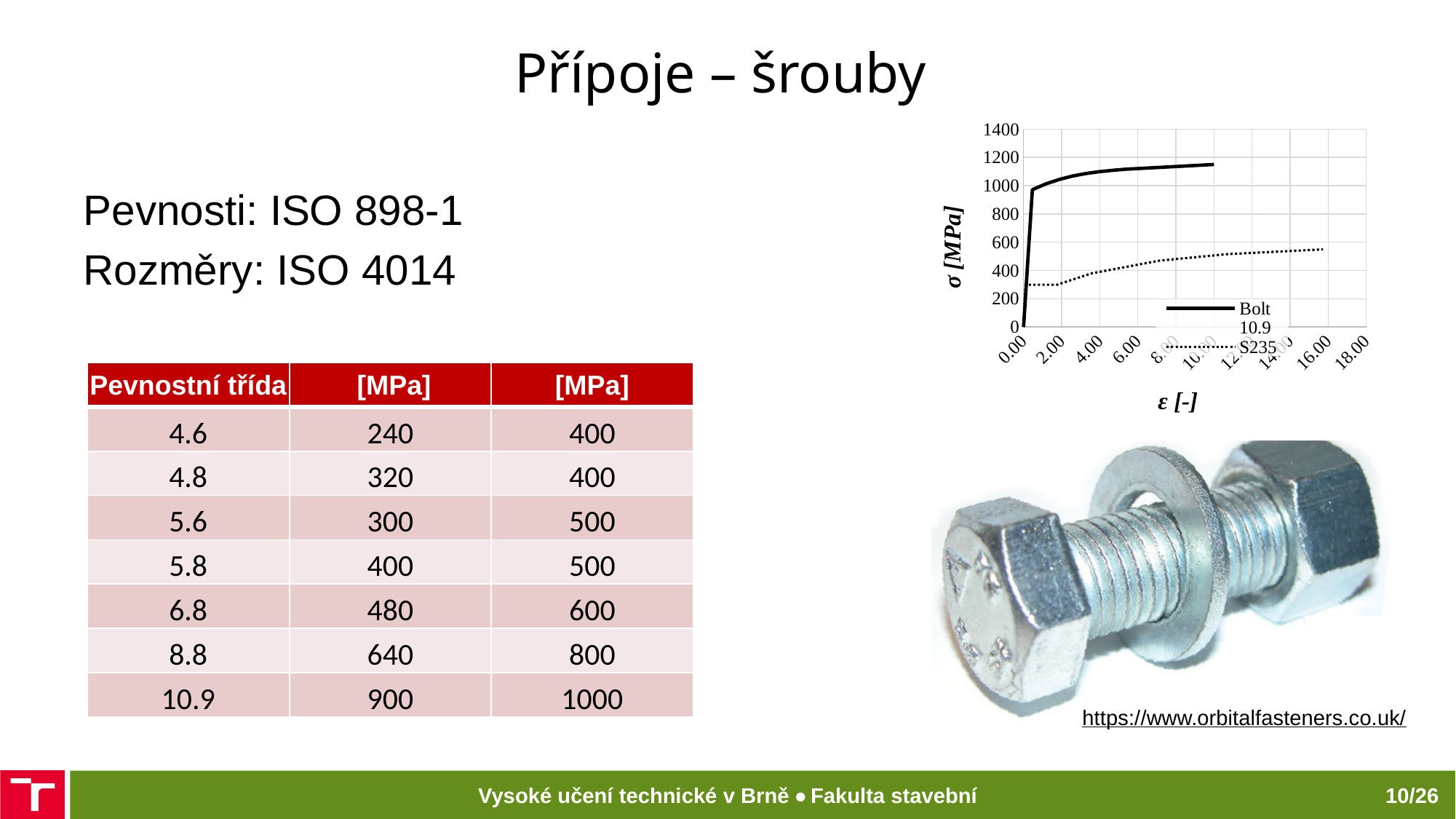
What kind of chart is shown on the slide? line chart Which series reaches the higher stress in the chart, Bolt 10.9 or S235? Bolt 10.9 What are the two series named in the chart's legend? Bolt 10.9 and S235 Which series is drawn with a dotted line in the chart? S235 Is the stress of the Bolt 10.9 curve at a strain of 4.00 greater or less than 800 MPa? greater Is the maximum stress of the Bolt 10.9 curve greater or less than 1000 MPa? greater How many series does the chart's legend list? 2 What is the label of the vertical axis of the chart? σ [MPa] Is the maximum stress of the S235 curve greater or less than 600 MPa? less Which series has the lower stress values throughout the chart? S235 Does the stress of the S235 curve generally rise or fall as strain increases along the x axis? rise